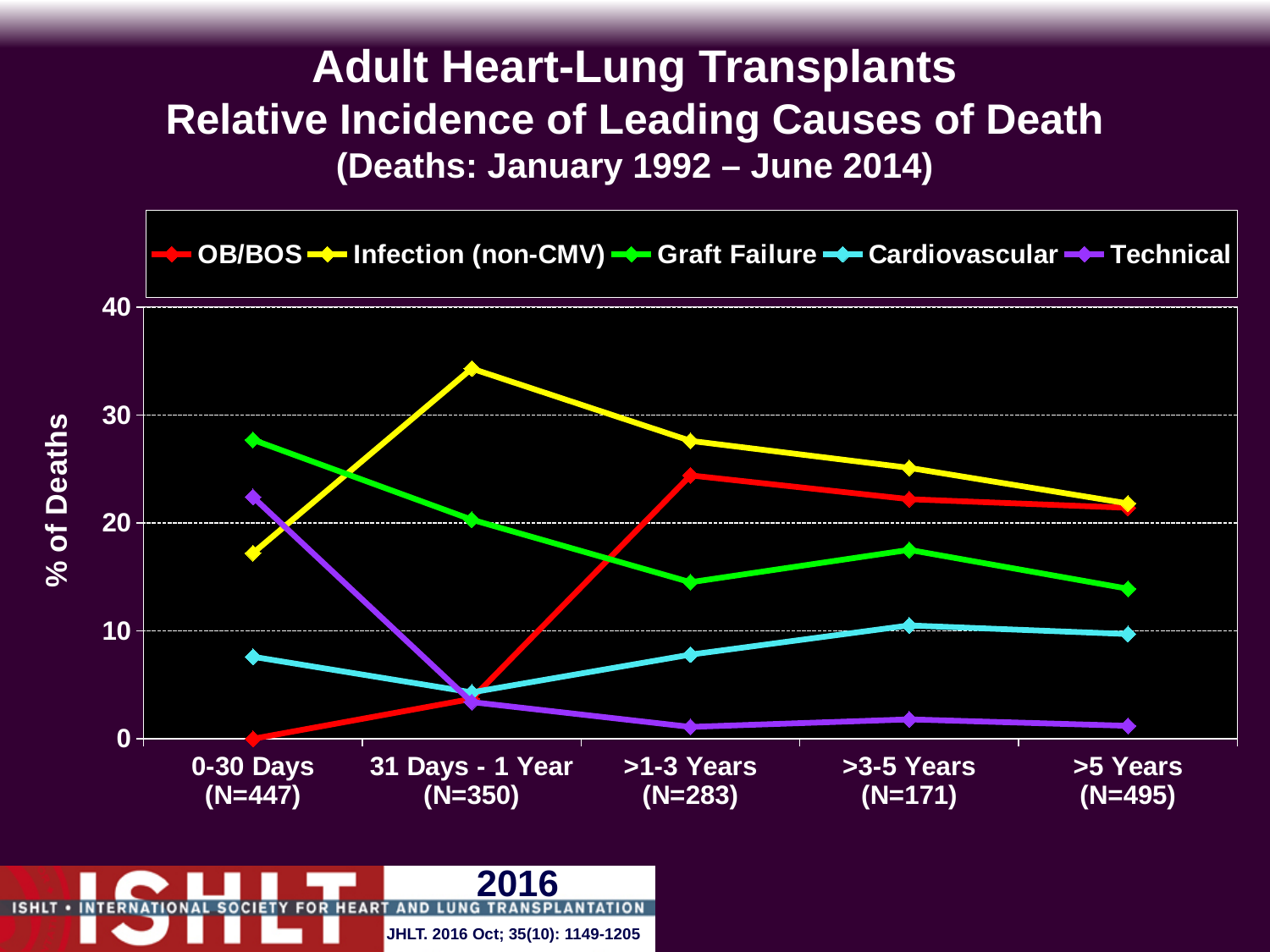
How many time-period categories are shown on the x axis? 5 Is the value for Graft Failure in the 0-30 Days period greater or less than 20? greater Does the Technical series rise or fall from 0-30 Days to >5 Years? Fall Is the value for OB/BOS in the 0-30 Days period greater or less than 10? less What is the y-axis title of the chart? % of Deaths In the >3-5 Years period, which is larger: Infection (non-CMV) or Graft Failure? Infection (non-CMV) How many series does the legend list? 5 Which cause of death has the lowest % of deaths in the >1-3 Years period? Technical Which cause of death has the highest % of deaths in the 0-30 Days period? Graft Failure Which cause of death has the highest % of deaths in the 31 Days - 1 Year period? Infection (non-CMV) What type of chart is shown on the slide? Line chart Is the value for Infection (non-CMV) in the 31 Days - 1 Year period greater or less than 30? greater